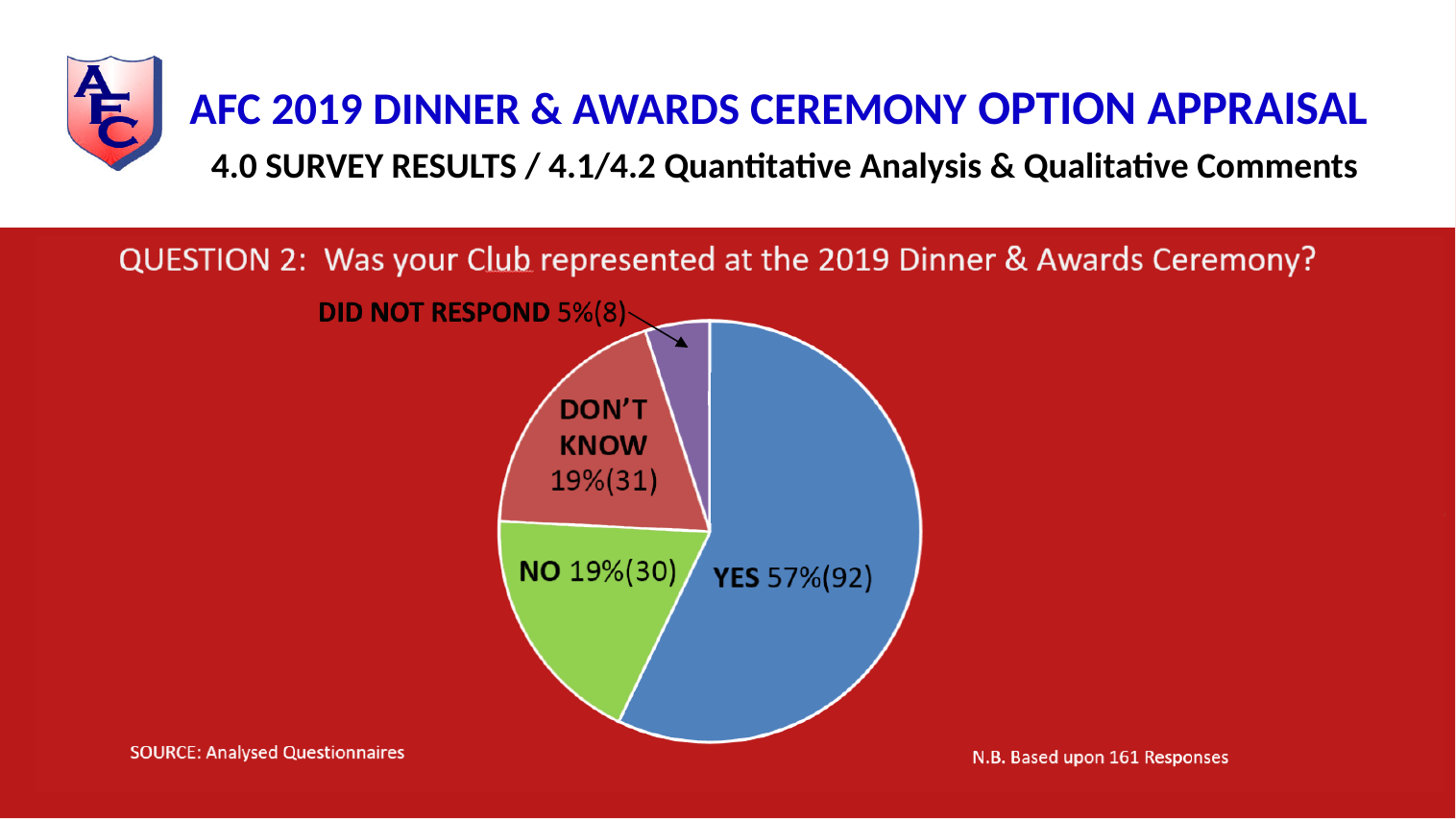
What is the total number of responses the chart is based upon? 161 What colour is the YES slice? blue What percentage of respondents answered YES? 57% Which response has the largest share of the pie? YES How many slices does the pie chart have? 4 How many respondents DID NOT RESPOND? 8 What is the difference in number of respondents between YES and NO? 62 Which has more respondents, DON'T KNOW or NO? DON'T KNOW Which response has the smallest share of the pie? DID NOT RESPOND What kind of chart is shown on the slide? pie chart What percentage of respondents answered DON'T KNOW? 19% How many respondents answered NO? 30